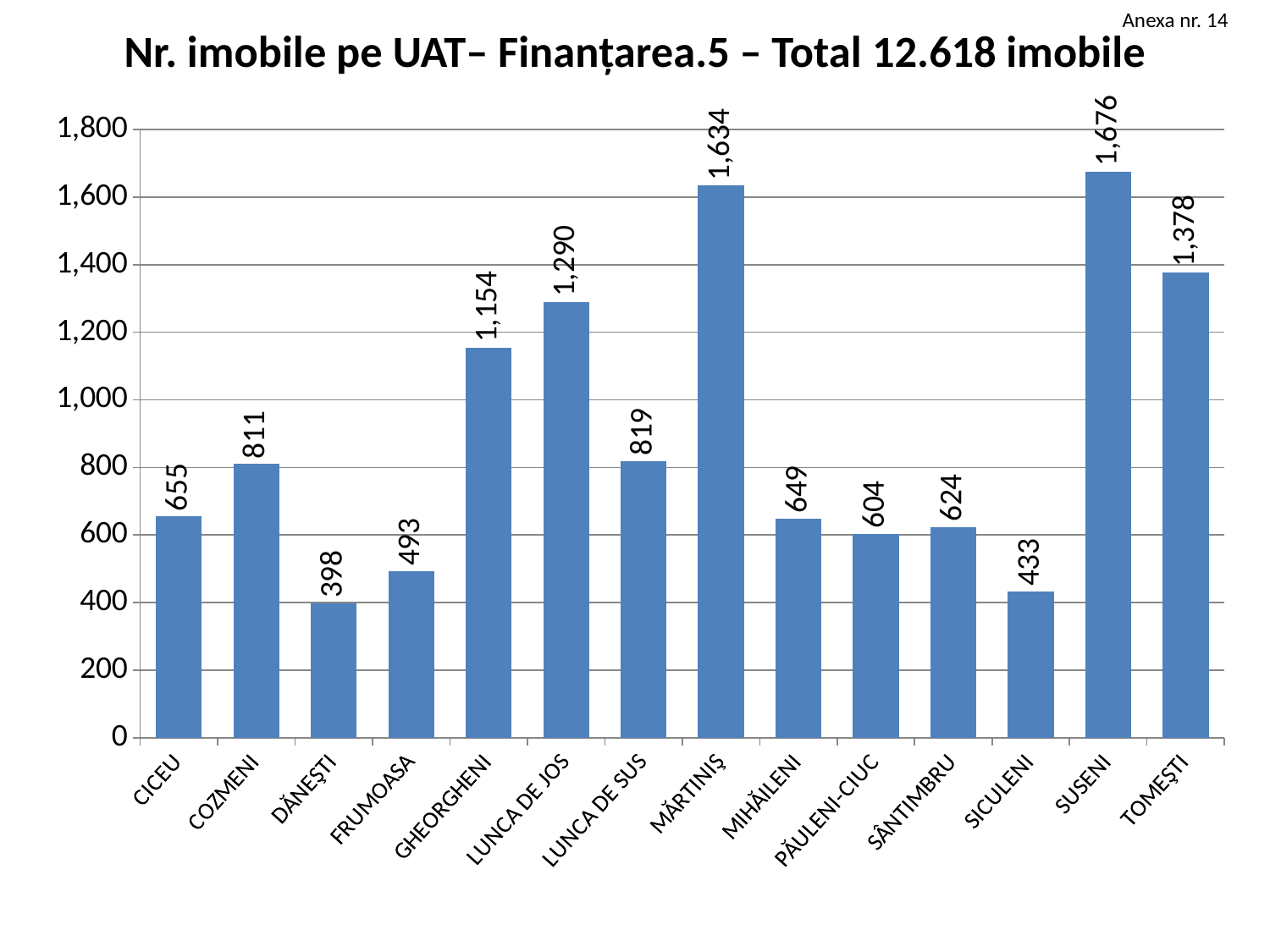
How many UATs are shown on the chart? 14 Is the value for LUNCA DE SUS greater or less than 1,000? less What kind of chart is shown on the slide? bar chart What total number of imobile is stated in the chart title? 12.618 Which is larger, the value for CICEU or the value for FRUMOASA? CICEU Which UAT has the lowest number of imobile? DĂNEȘTI What is the value for TOMEȘTI? 1,378 What is the difference between the values for SUSENI and MĂRTINIȘ? 42 Which UAT has the highest number of imobile? SUSENI What is the value for SICULENI? 433 What is the value for GHEORGHENI? 1,154 What is the difference between the values for LUNCA DE JOS and GHEORGHENI? 136